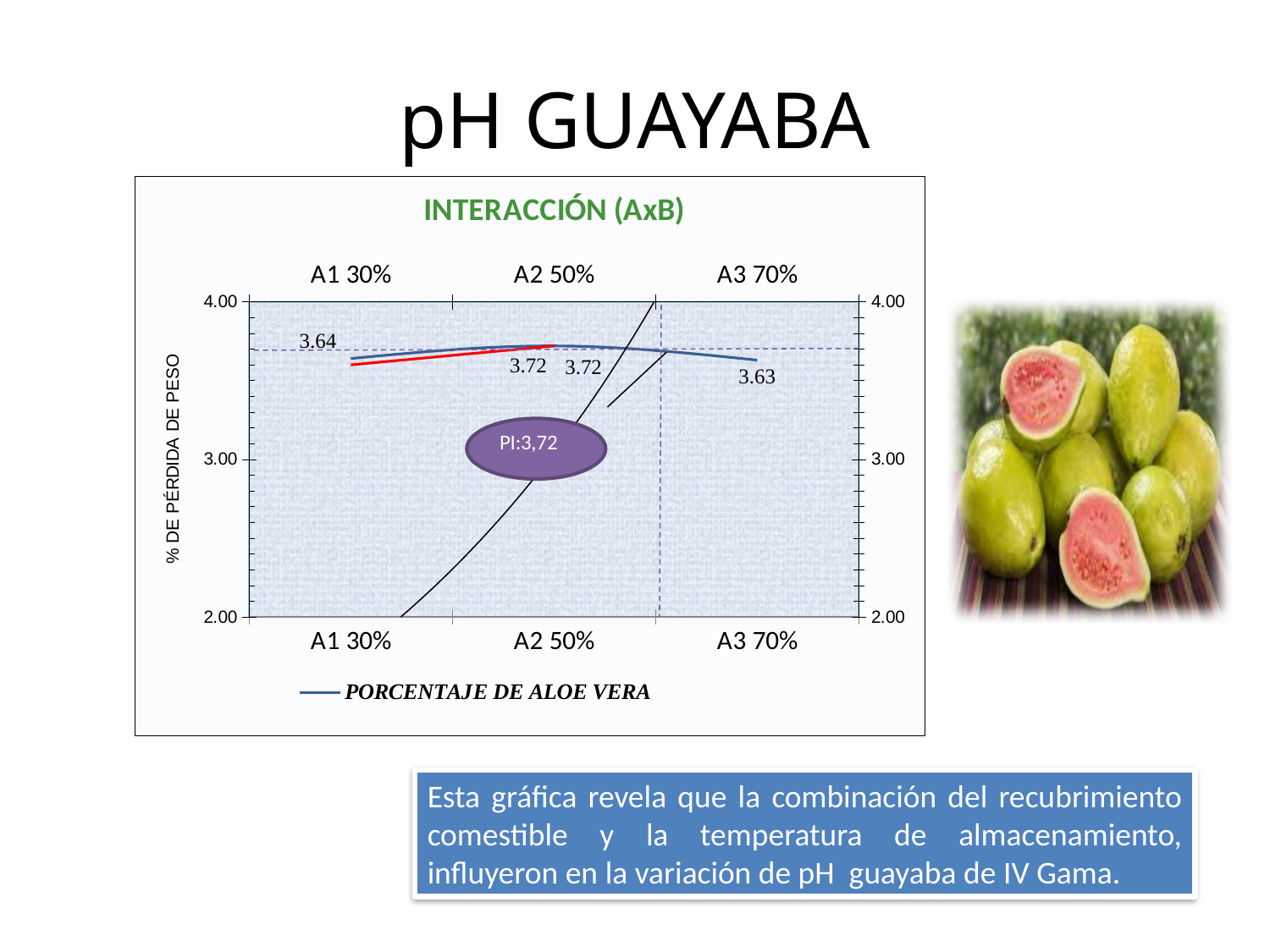
How many categories are plotted on the x axis of the INTERACCIÓN (AxB) chart? 3 What kind of chart is the INTERACCIÓN (AxB) chart? line chart What is the value for A2 50% on the INTERACCIÓN (AxB) chart? 3.72 Is the value for A3 70% on the INTERACCIÓN (AxB) chart greater or less than 3.00? greater What is the legend entry shown on the INTERACCIÓN (AxB) chart? PORCENTAJE DE ALOE VERA What is the difference between the values for A2 50% and A1 30% on the INTERACCIÓN (AxB) chart? 0.08 Which category has the lowest value on the INTERACCIÓN (AxB) chart? A3 70% What is the value for A1 30% on the INTERACCIÓN (AxB) chart? 3.64 How many series does the legend of the INTERACCIÓN (AxB) chart list? 1 Which category has the highest value on the INTERACCIÓN (AxB) chart? A2 50% Which is larger on the INTERACCIÓN (AxB) chart, the value for A2 50% or the value for A3 70%? A2 50% What is the value for A3 70% on the INTERACCIÓN (AxB) chart? 3.63